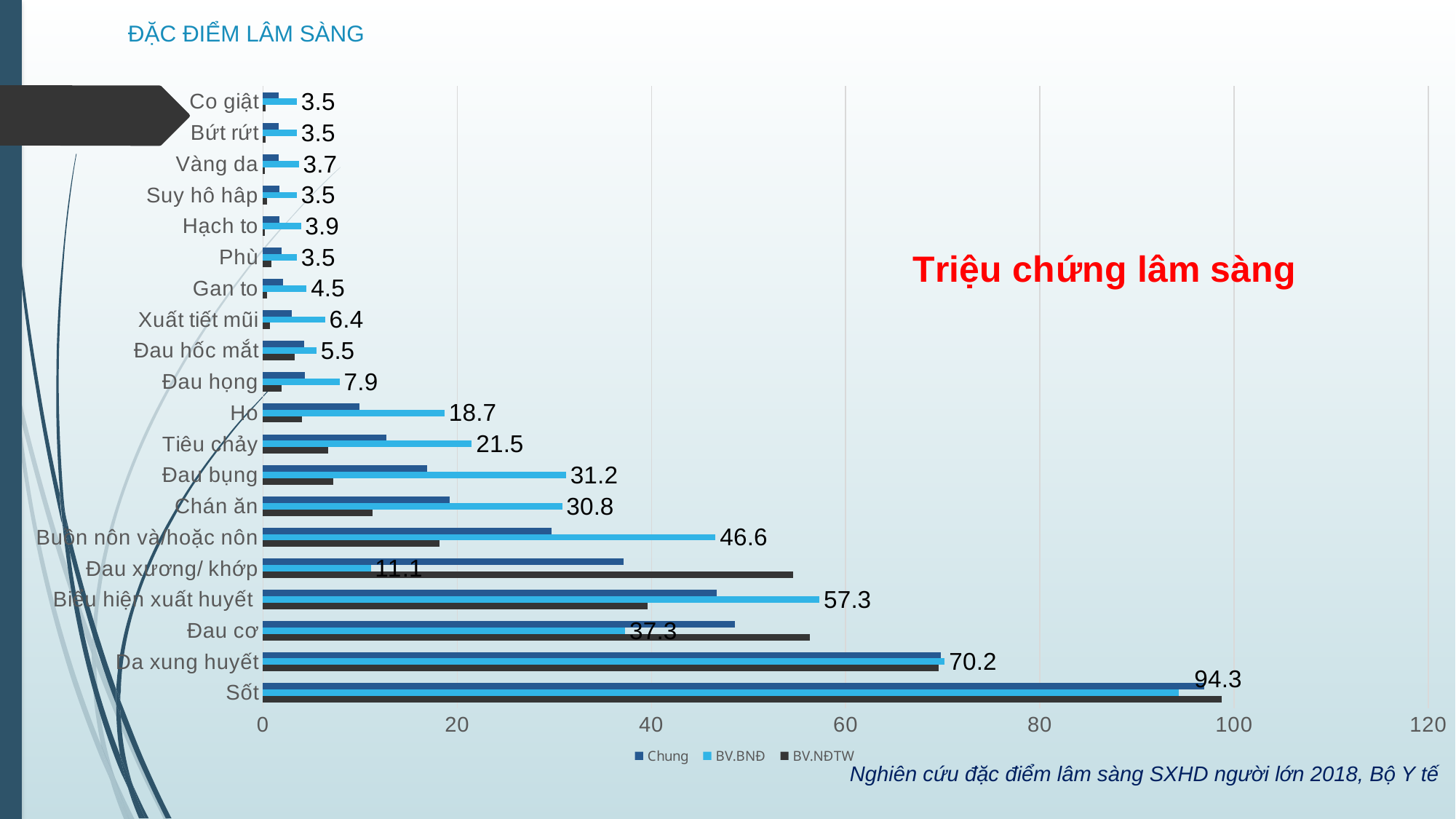
Which category has the highest BV.BNĐ value? Sốt What is the BV.BNĐ value for Biểu hiện xuất huyết? 57.3 Is the BV.NĐTW value for Đau xương/ khớp greater or less than 40? greater What kind of chart is shown on the slide? Bar chart How many symptom categories are shown on the chart? 20 What is the difference between the BV.BNĐ values for Da xung huyết and Đau cơ? 32.9 What is the difference between the BV.BNĐ values for Tiêu chảy and Ho? 2.8 Is the Chung value for Sốt greater or less than 80? greater What is the BV.BNĐ value for Sốt? 94.3 How many series does the legend list? 3 What is the BV.BNĐ value for Buồn nôn và hoặc nôn? 46.6 Which has the larger BV.BNĐ value, Đau bụng or Chán ăn? Đau bụng